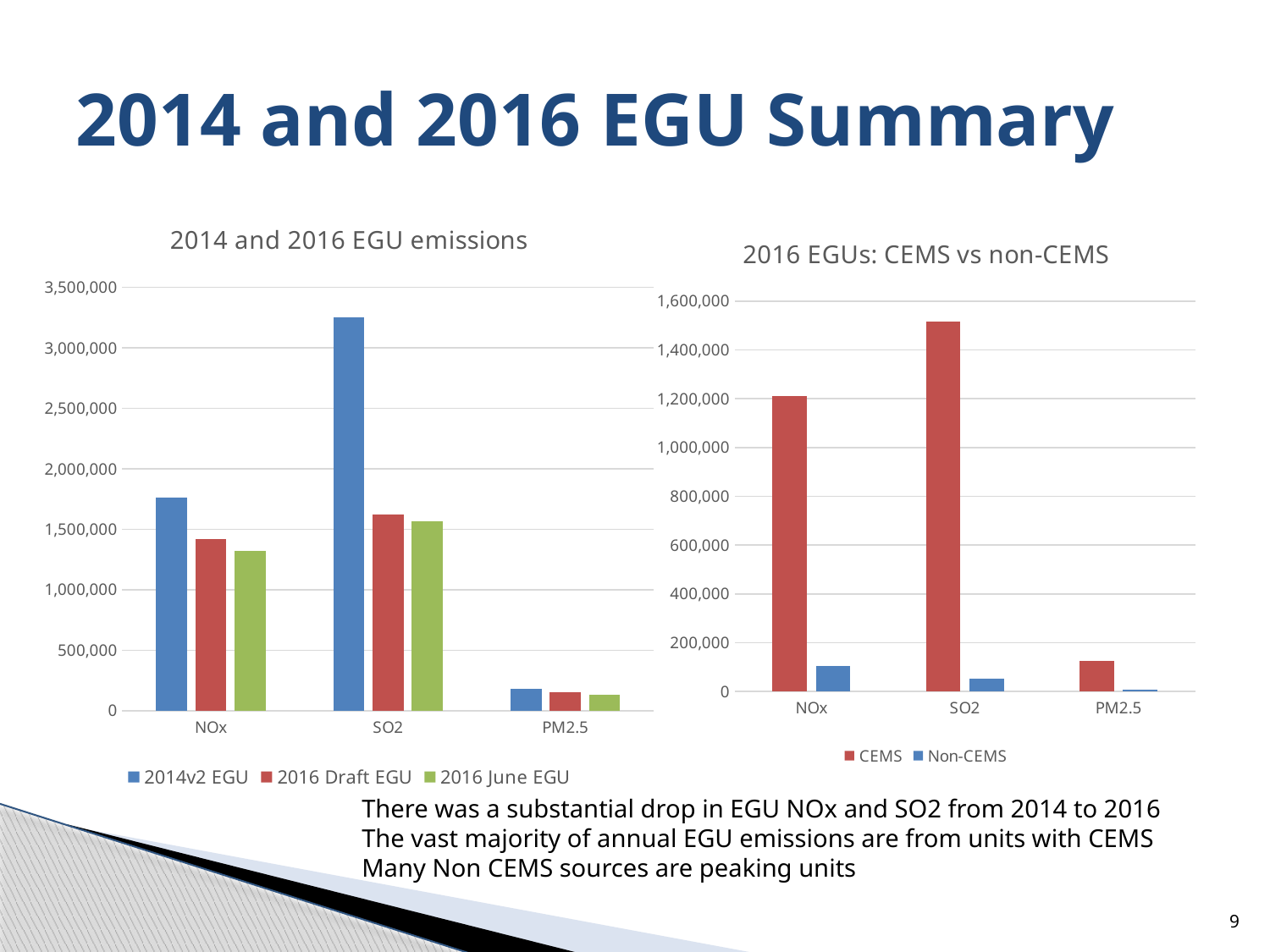
On the chart titled '2016 EGUs: CEMS vs non-CEMS', which category has the lowest Non-CEMS value? PM2.5 On the chart titled '2016 EGUs: CEMS vs non-CEMS', how many series does the legend list? 2 On the chart titled '2014 and 2016 EGU emissions', how many pollutant categories are shown on the x axis? 3 On the chart titled '2014 and 2016 EGU emissions', is the 2016 Draft EGU value for NOx greater or less than 1,500,000? less On the chart titled '2016 EGUs: CEMS vs non-CEMS', which category has the highest CEMS value? SO2 On the chart titled '2016 EGUs: CEMS vs non-CEMS', for NOx, which is larger: CEMS or Non-CEMS? CEMS On the chart titled '2014 and 2016 EGU emissions', which category has the highest 2014v2 EGU value? SO2 On the chart titled '2014 and 2016 EGU emissions', what kind of chart is shown? bar chart On the chart titled '2014 and 2016 EGU emissions', how many series does the legend list? 3 On the chart titled '2014 and 2016 EGU emissions', for SO2, which is larger: the 2014v2 EGU value or the 2016 June EGU value? 2014v2 EGU On the chart titled '2016 EGUs: CEMS vs non-CEMS', is the CEMS value for NOx greater or less than 1,000,000? greater On the chart titled '2014 and 2016 EGU emissions', is the 2014v2 EGU value for SO2 greater or less than 3,000,000? greater